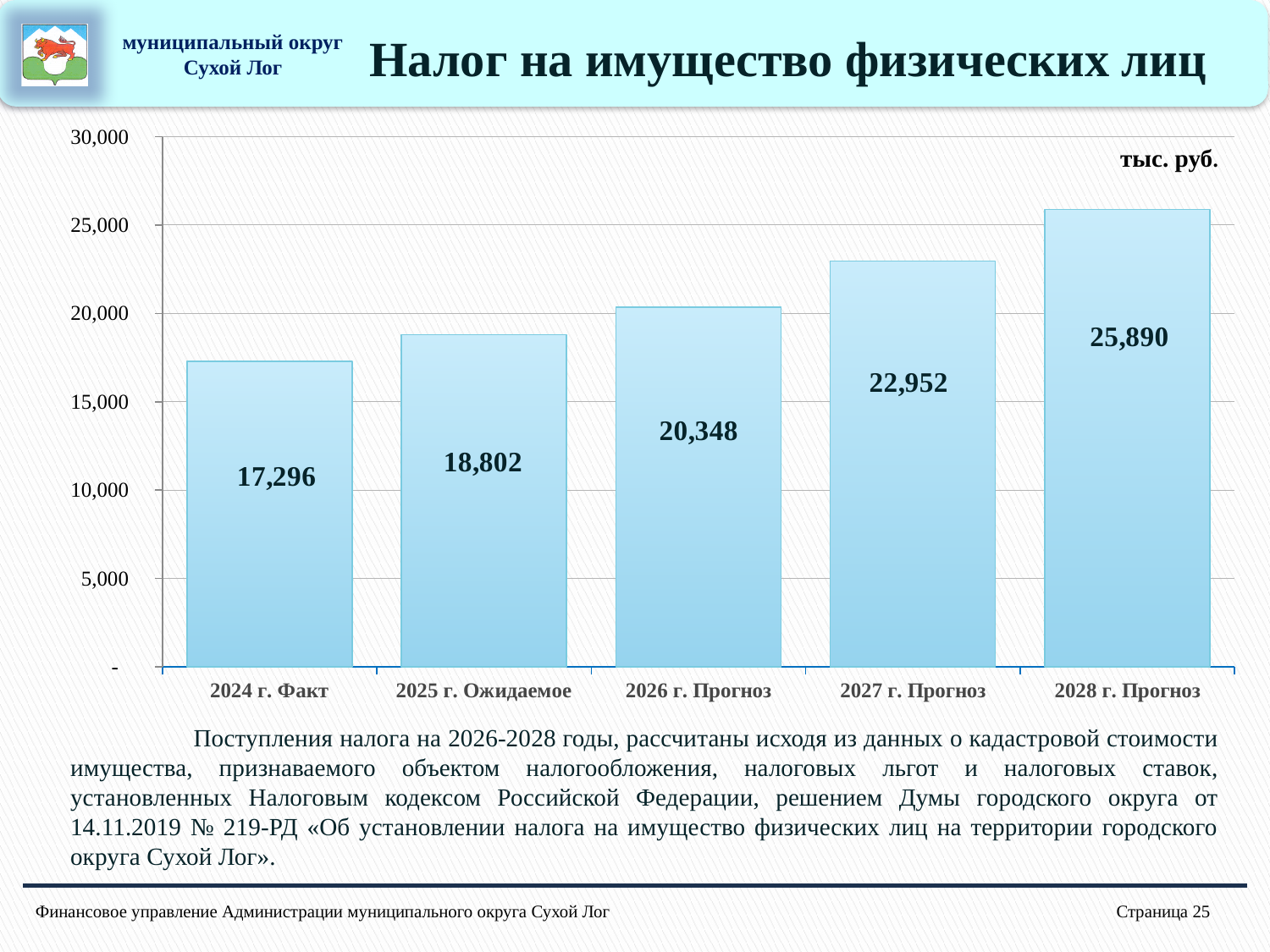
Which is larger, the value for 2026 г. Прогноз or the value for 2025 г. Ожидаемое? 2026 г. Прогноз What is the value for 2026 г. Прогноз? 20,348 Which category has the highest value? 2028 г. Прогноз What is the difference between the values for 2025 г. Ожидаемое and 2024 г. Факт? 1,506 How many categories are shown on the x axis? 5 What is the value for 2024 г. Факт? 17,296 Which category has the lowest value? 2024 г. Факт What is the value for 2028 г. Прогноз? 25,890 What kind of chart is shown on the slide? bar chart Do the values rise or fall from 2024 г. Факт to 2028 г. Прогноз? rise What is the difference between the values for 2028 г. Прогноз and 2027 г. Прогноз? 2,938 Is the value for 2027 г. Прогноз greater or less than 20,000? greater